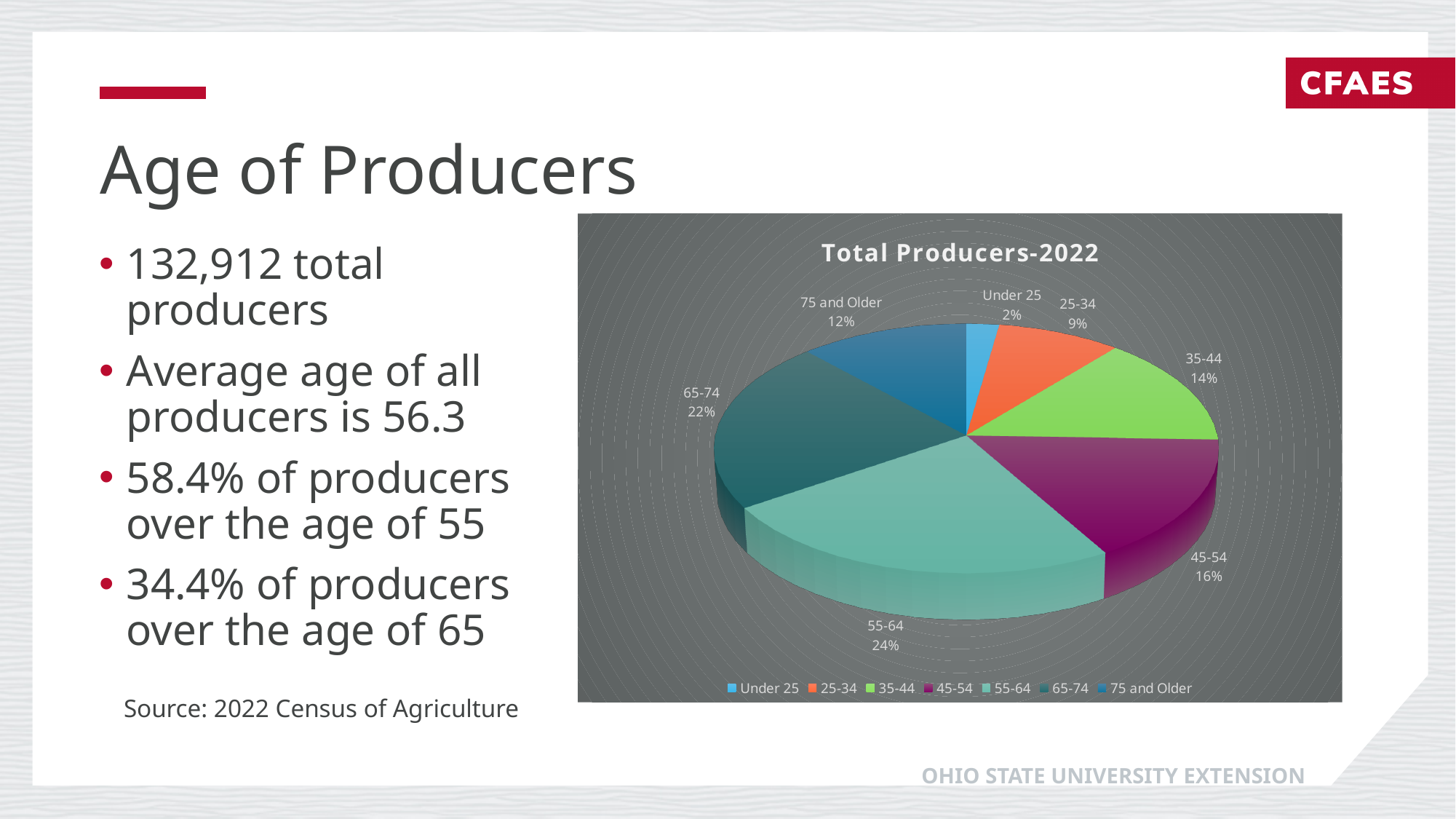
Which age group has the smallest share of producers? Under 25 What share of producers are 75 and Older? 12% What type of chart is shown on the slide? Pie chart Which age group has the largest share of producers? 55-64 What share of producers are in the 65-74 age group? 22% What share of producers are Under 25? 2% Which age group has a larger share, 45-54 or 35-44? 45-54 What is the title of the chart? Total Producers-2022 What share of producers are in the 55-64 age group? 24% What is the difference in percentage points between the 35-44 and 25-34 age groups? 5 How many age groups are shown in the pie chart? 7 What colour is the slice for the 35-44 age group? Green